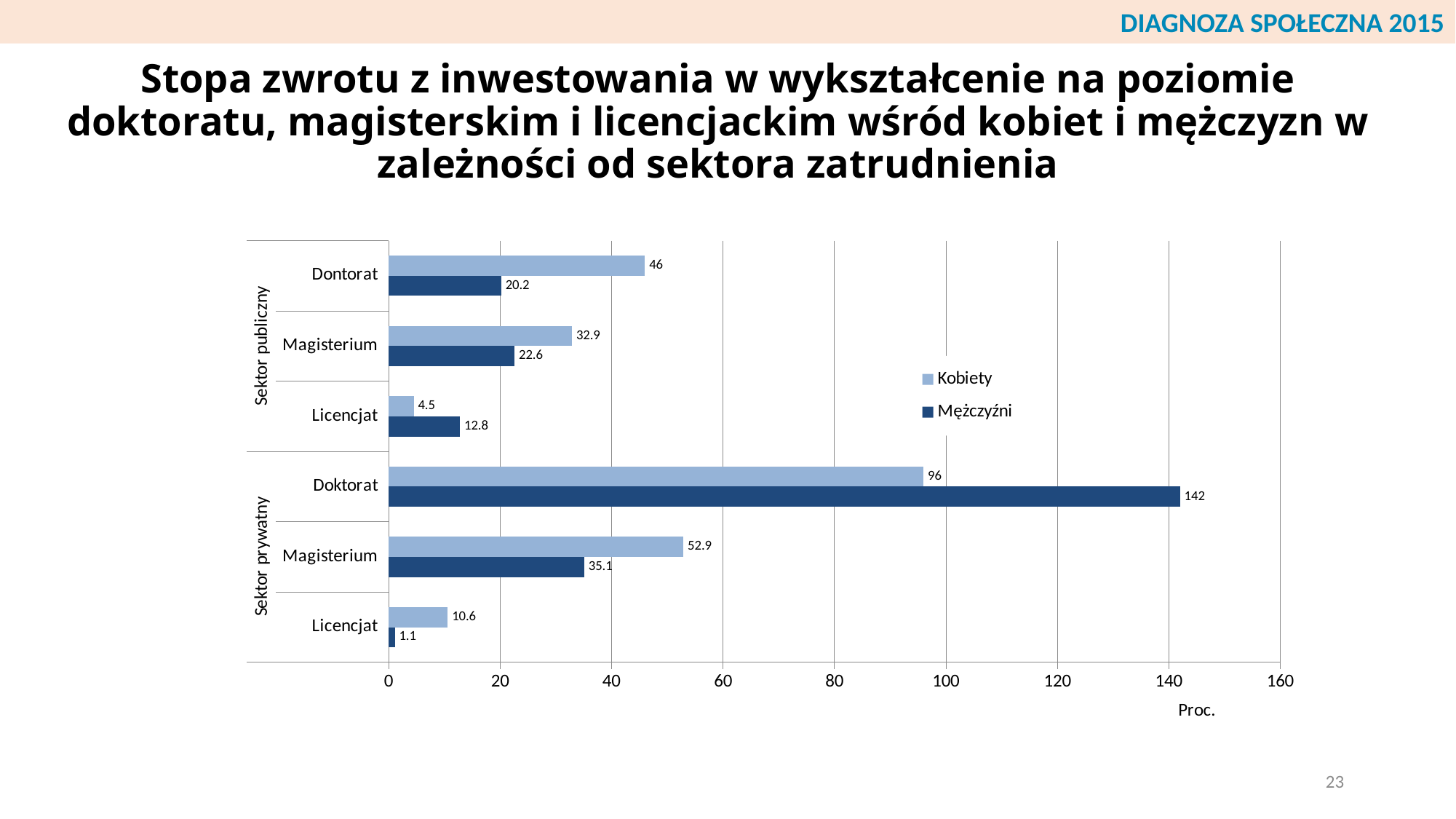
What is the value for Kobiety for Licencjat in Sektor publiczny? 4.5 What is the difference between the Mężczyźni and Kobiety values for Doktorat in Sektor prywatny? 46 How many series does the legend list? 2 What unit label is shown at the end of the horizontal axis? Proc. What is the value for Mężczyźni for Doktorat in Sektor prywatny? 142 Is the Kobiety value for Magisterium in Sektor prywatny greater or less than 40? greater Which is larger for Licencjat in Sektor publiczny: the Kobiety value or the Mężczyźni value? Mężczyźni Which category has the highest Mężczyźni value? Doktorat (Sektor prywatny) Which category has the lowest Mężczyźni value? Licencjat (Sektor prywatny) What is the value for Mężczyźni for Magisterium in Sektor publiczny? 22.6 What is the value for Kobiety for Doktorat in Sektor prywatny? 96 What kind of chart is shown on the slide? bar chart